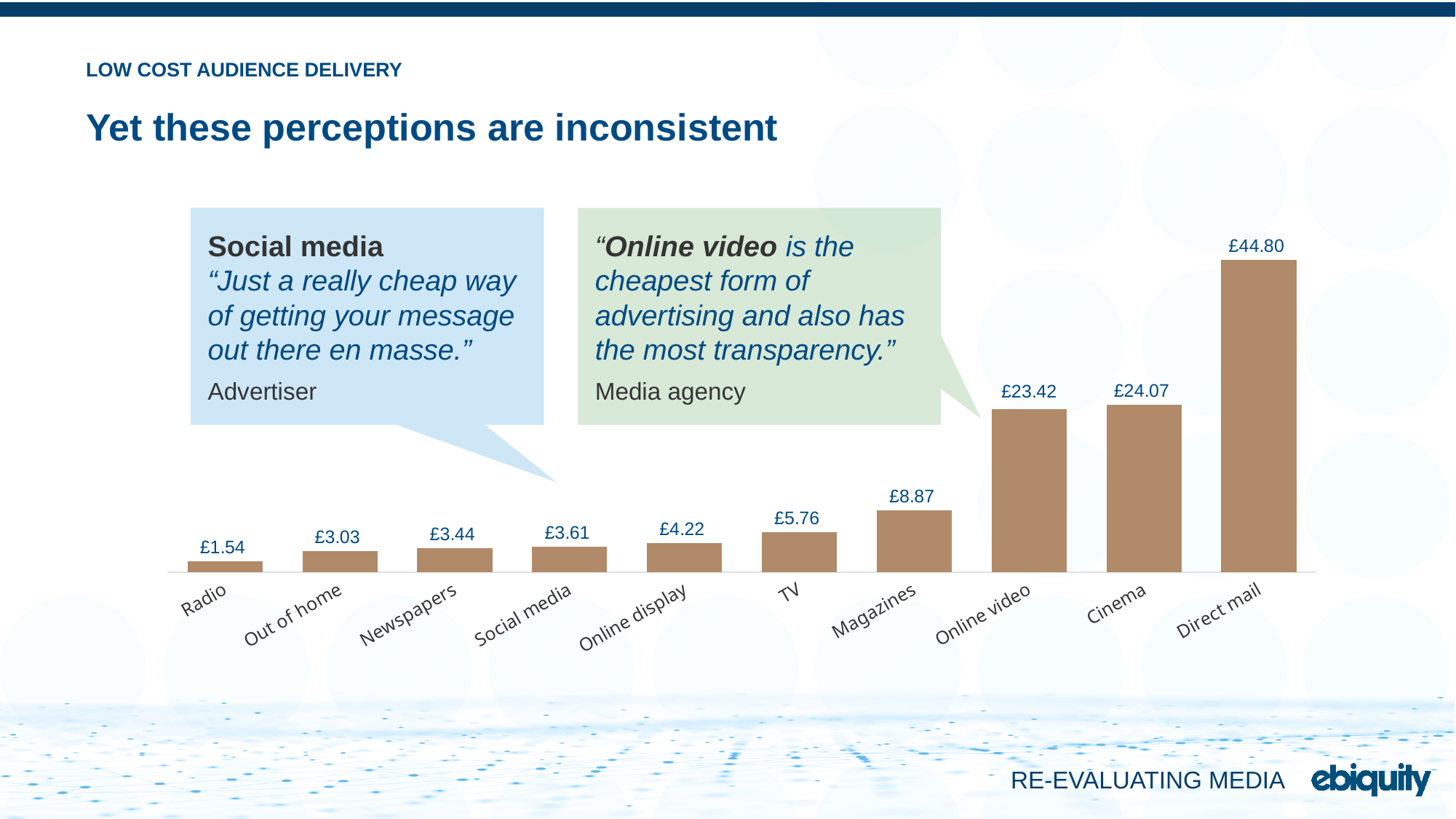
What is the value for Online video? £23.42 Do the values rise or fall from left to right along the x axis? Rise Who is quoted as saying online video is the cheapest form of advertising? Media agency Which category has the lowest value? Radio What is the value for Radio? £1.54 What is the value for Social media? £3.61 What is the difference between the values for Online video and Social media? £19.81 What kind of chart is shown on the slide? Bar chart What is the difference between the values for Direct mail and Cinema? £20.73 How many categories are shown on the chart? 10 Which is larger, the value for TV or the value for Magazines? Magazines Which category has the highest value? Direct mail